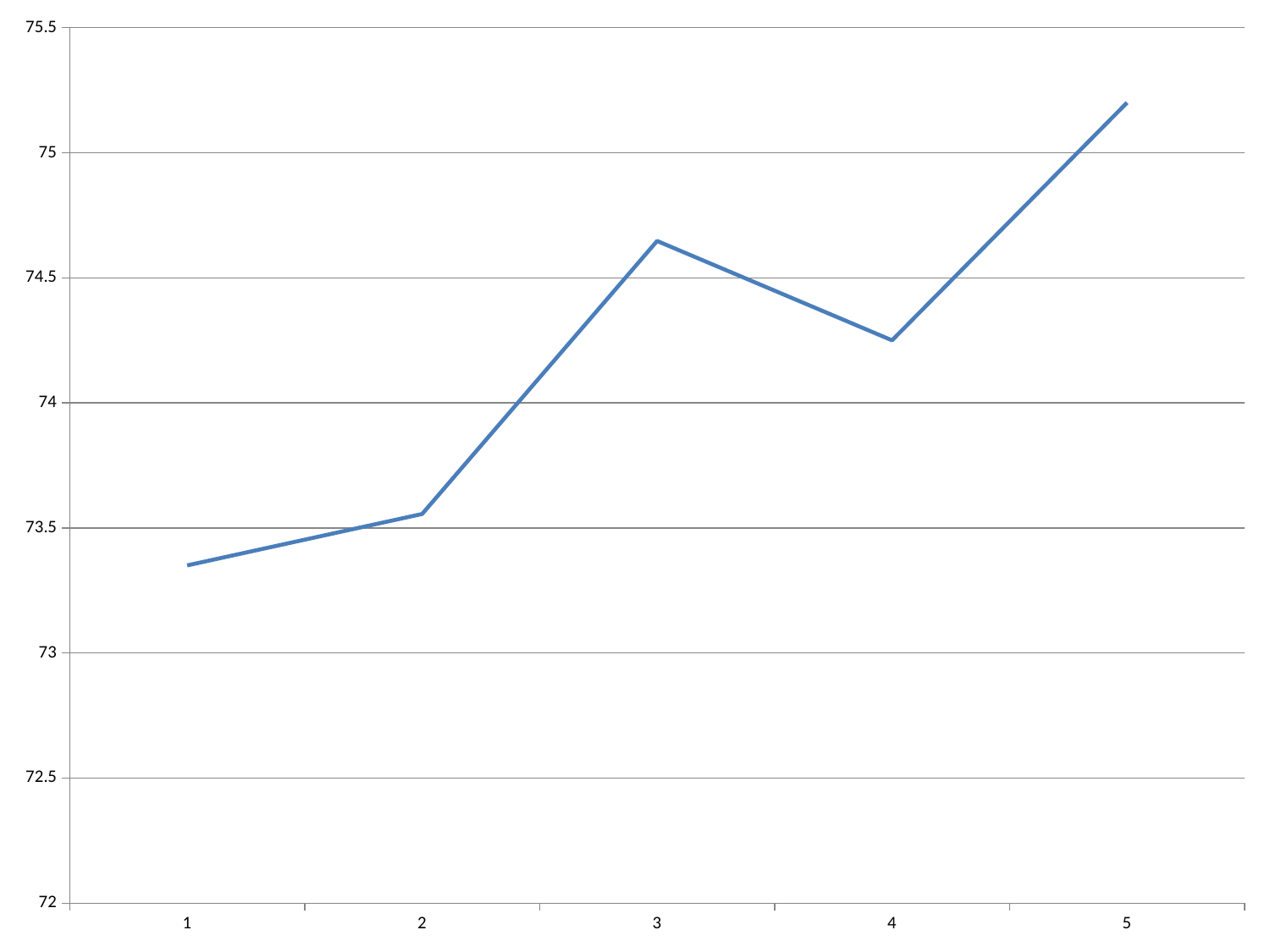
What kind of chart is shown on the slide? line chart Which has the larger value, category 2 or category 5? 5 Which has the larger value, category 3 or category 4? 3 At which x-axis category does the line reach its lowest value? 1 Is the value at category 4 greater or less than 74.5? less Is the value at category 5 greater or less than 75? greater At which x-axis category does the line reach its highest value? 5 Is the value at category 3 greater or less than 74.5? greater Does the line rise or fall between category 3 and category 4? fall How many points are plotted on the line? 5